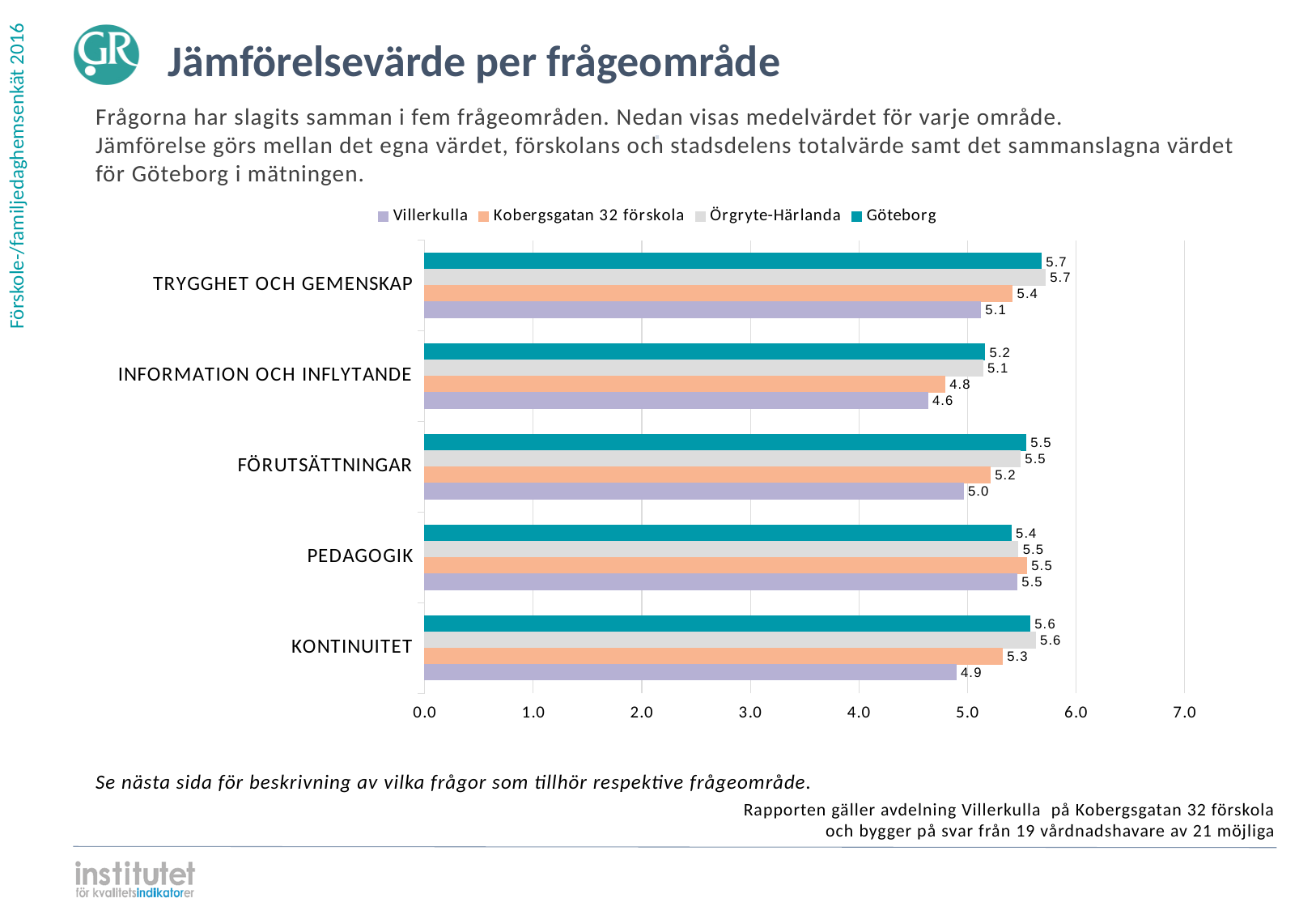
Which series is shown in teal (dark green) on the chart? Göteborg For KONTINUITET, which is larger: the Kobergsgatan 32 förskola value or the Villerkulla value? Kobergsgatan 32 förskola What is the Kobergsgatan 32 förskola value for FÖRUTSÄTTNINGAR? 5.2 Which category has the lowest Villerkulla value? INFORMATION OCH INFLYTANDE How many series does the legend list? 4 What is the Villerkulla value for INFORMATION OCH INFLYTANDE? 4.6 What is the Göteborg value for KONTINUITET? 5.6 What is the difference between the Örgryte-Härlanda and Villerkulla values for KONTINUITET? 0.7 What type of chart is shown on the slide? Bar chart How many question areas (categories) are shown on the chart? 5 What is the difference between the Göteborg and Villerkulla values for TRYGGHET OCH GEMENSKAP? 0.6 Which category has the highest Villerkulla value? PEDAGOGIK